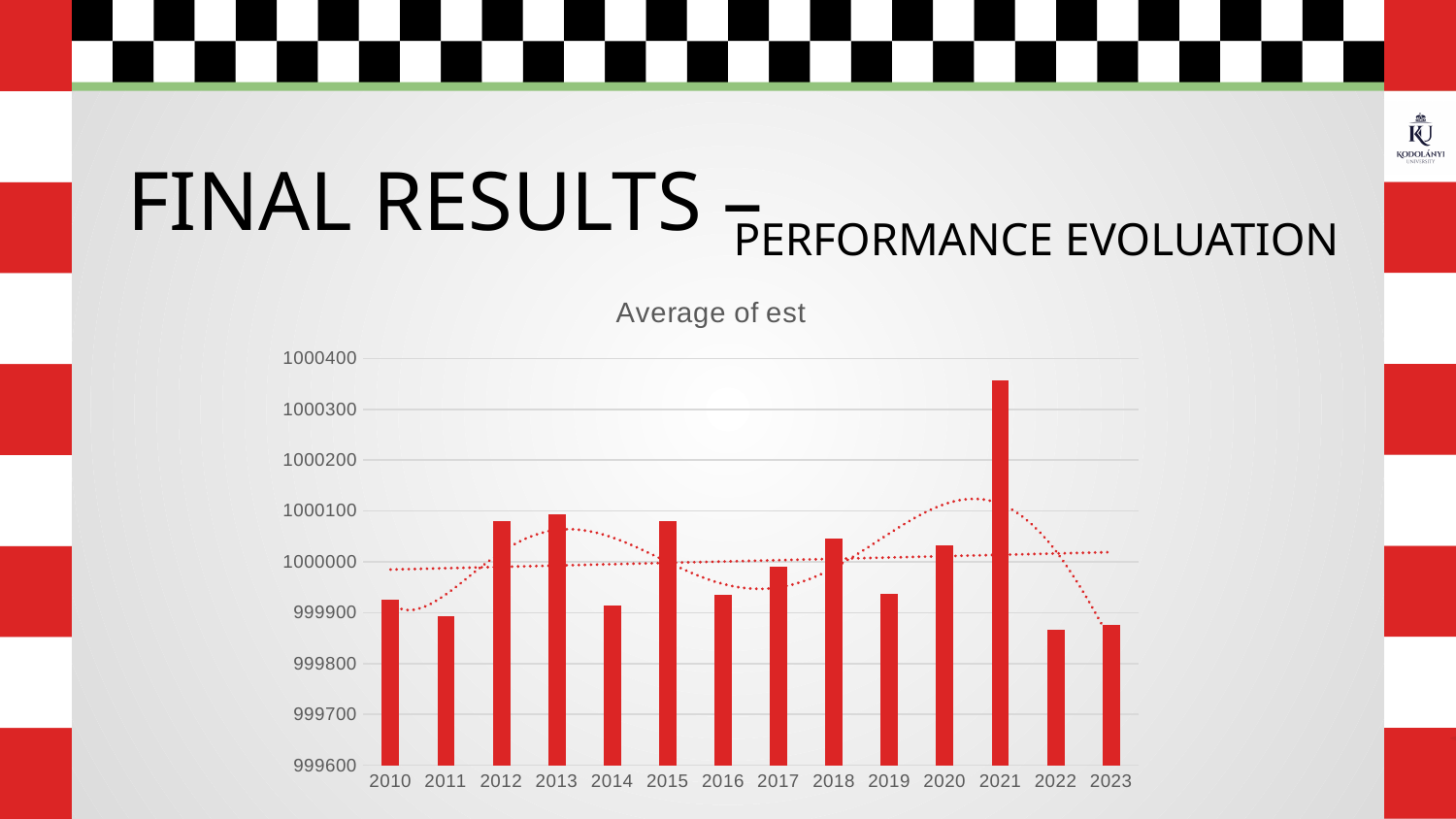
How many years are shown on the x axis of the chart? 14 Is the value for 2021 greater or less than 1000300? greater Is the value for 2011 greater or less than 1000000? less Which is larger, the value for 2018 or the value for 2019? 2018 What is the title of the chart? Average of est Is the value for 2022 greater or less than 999900? less What colour are the bars in the chart? red Which is larger, the value for 2021 or the value for 2012? 2021 Which year has the highest value in the chart? 2021 What kind of chart is shown on the slide? bar chart